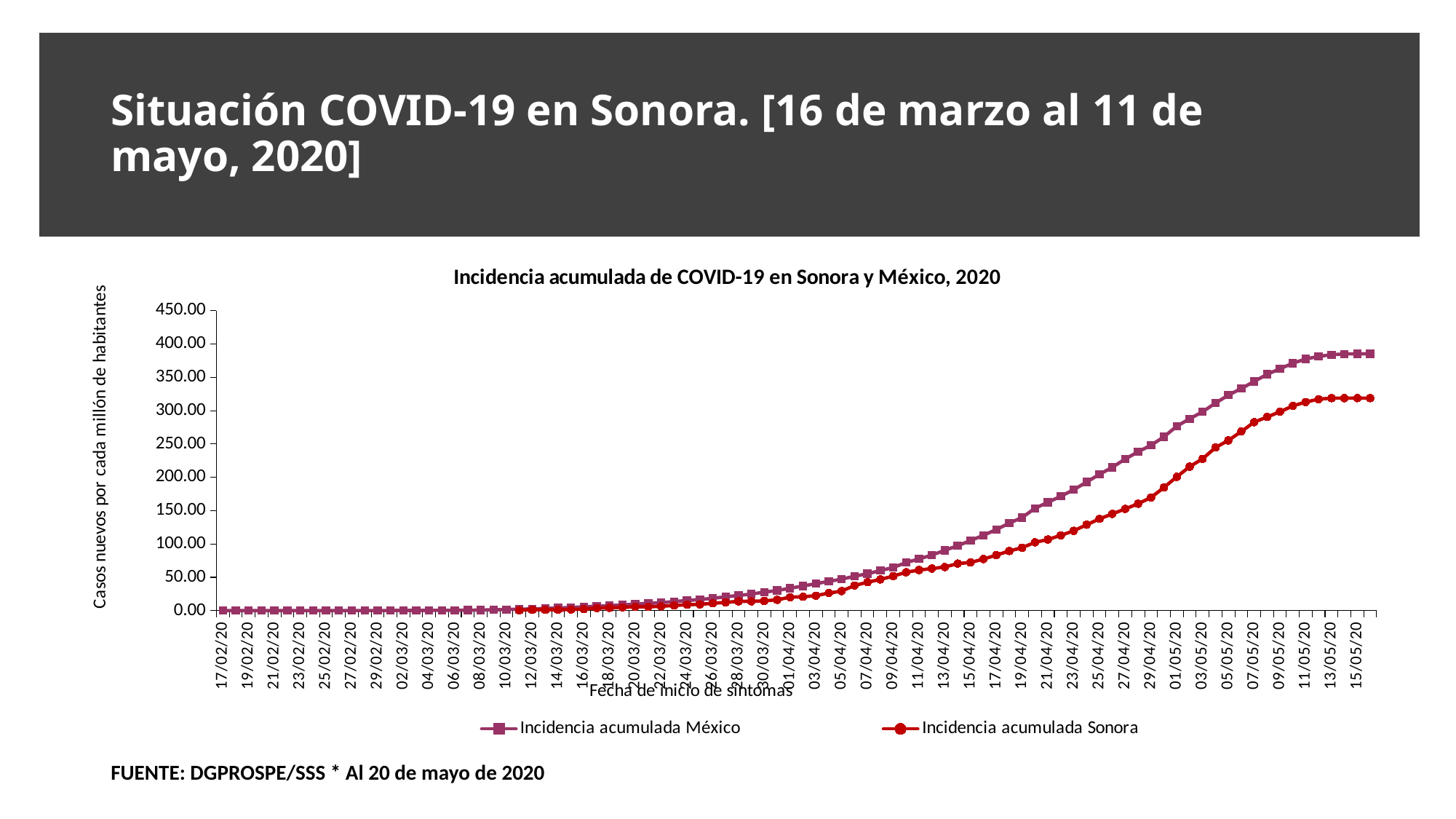
Which series is higher at the end of the period, Incidencia acumulada México or Incidencia acumulada Sonora? Incidencia acumulada México Is the value for Incidencia acumulada Sonora on 15/04/20 greater or less than 100.00? less Do the values for Incidencia acumulada Sonora rise or fall along the x axis? rise Is the final value for Incidencia acumulada Sonora greater or less than 350.00? less What is the title of the chart? Incidencia acumulada de COVID-19 en Sonora y México, 2020 Is the final value for Incidencia acumulada México greater or less than 350.00? greater Which series has the lower value on 09/05/20? Incidencia acumulada Sonora What is the label of the y axis? Casos nuevos por cada millón de habitantes What kind of chart is shown on the slide? line chart How many series does the legend list? 2